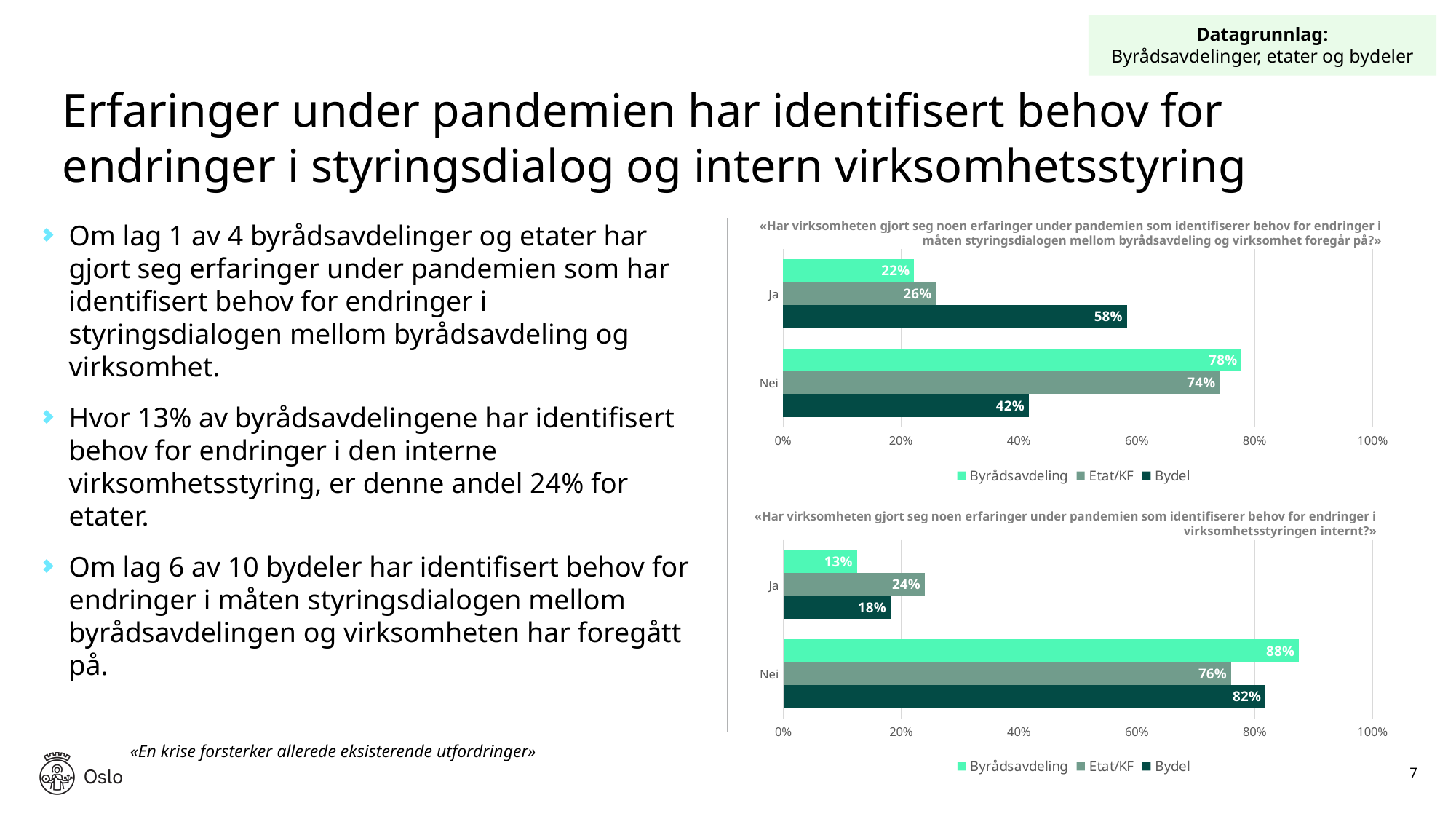
In the top chart, what is the value for Byrådsavdeling in the Nei category? 78% In the top chart, what is the value for Bydel in the Ja category? 58% In the bottom chart, what is the value for Bydel in the Nei category? 82% In the bottom chart, which is larger in the Nei category: Byrådsavdeling or Etat/KF? Byrådsavdeling In the top chart, is the value for Bydel in the Nei category greater or less than 40%? greater In the top chart, which series has the highest value in the Ja category? Bydel What kind of chart is the top chart? Bar chart In the top chart, what is the difference between the Bydel and Byrådsavdeling values in the Ja category? 36 percentage points How many series does the legend of the bottom chart list? 3 How many categories are shown on the y axis of the bottom chart? 2 In the bottom chart, what is the value for Etat/KF in the Ja category? 24% In the bottom chart, which series has the lowest value in the Ja category? Byrådsavdeling